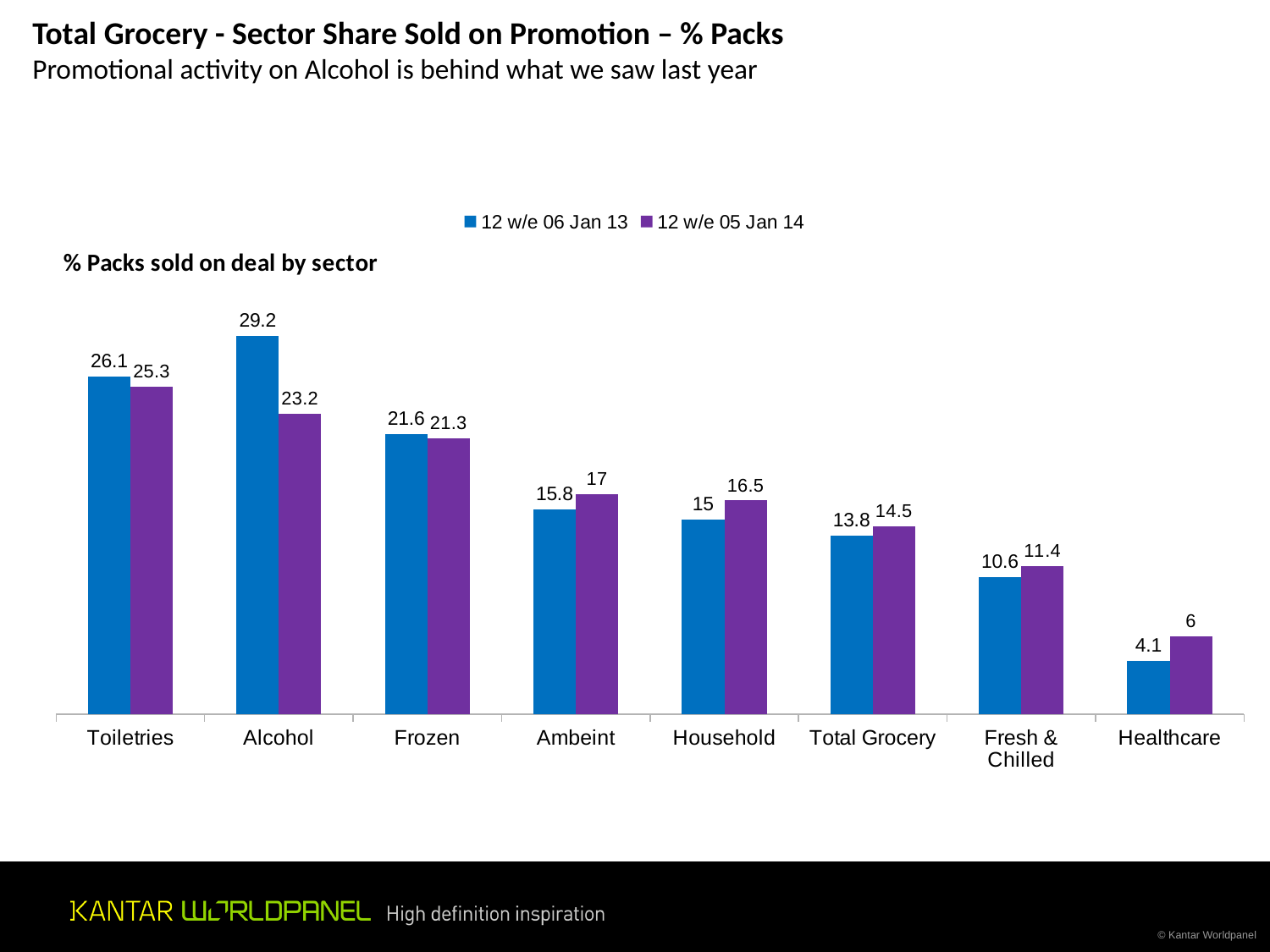
What is the value for Fresh & Chilled in the 12 w/e 06 Jan 13 series? 10.6 What is the value for Healthcare in the 12 w/e 05 Jan 14 series? 6 Which sector has the highest value in the 12 w/e 05 Jan 14 series? Toiletries Which is larger for Household: the 12 w/e 06 Jan 13 value or the 12 w/e 05 Jan 14 value? 12 w/e 05 Jan 14 How many sectors are shown on the x axis? 8 What kind of chart is shown on the slide? Bar chart How many series does the legend list? 2 What is the difference between the 12 w/e 05 Jan 14 and 12 w/e 06 Jan 13 values for Total Grocery? 0.7 What is the difference between the 12 w/e 06 Jan 13 and 12 w/e 05 Jan 14 values for Alcohol? 6 Which sector has the lowest value in the 12 w/e 06 Jan 13 series? Healthcare What is the value for Alcohol in the 12 w/e 06 Jan 13 series? 29.2 What is the title of the chart? % Packs sold on deal by sector